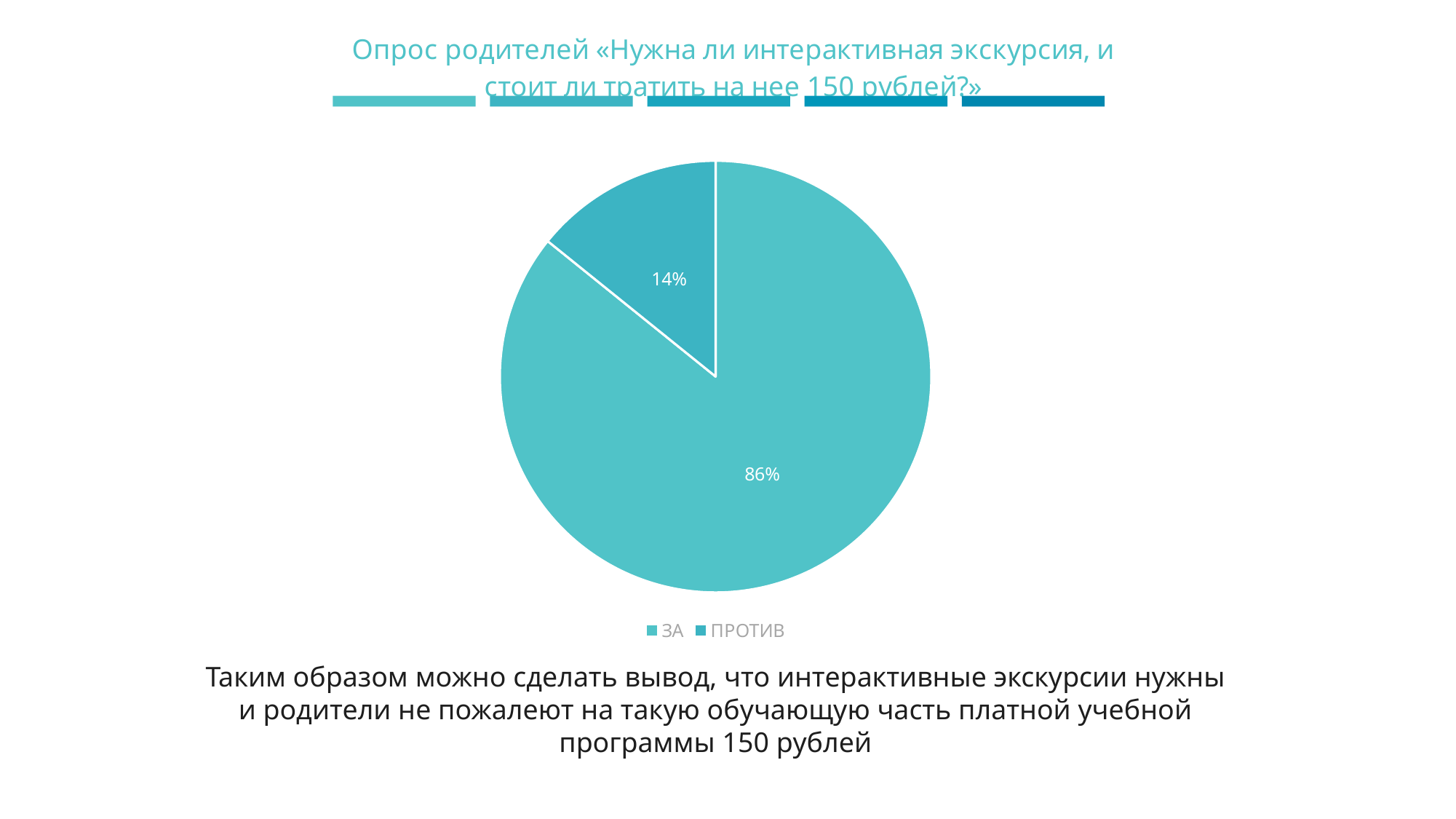
How many slices does the pie chart have? 2 What is the total of the two slice percentages shown on the pie chart? 100% What kind of chart is shown on the slide? pie chart What are the two legend entries of the pie chart? ЗА and ПРОТИВ How many entries does the legend list? 2 What share of the pie does the ПРОТИВ slice take? 14% Which category has the largest slice of the pie? ЗА What share of the pie does the ЗА slice take? 86% Which category has the smallest slice of the pie? ПРОТИВ Which is larger, the ЗА slice or the ПРОТИВ slice? ЗА What is the difference in percentage points between the ЗА and ПРОТИВ slices? 72